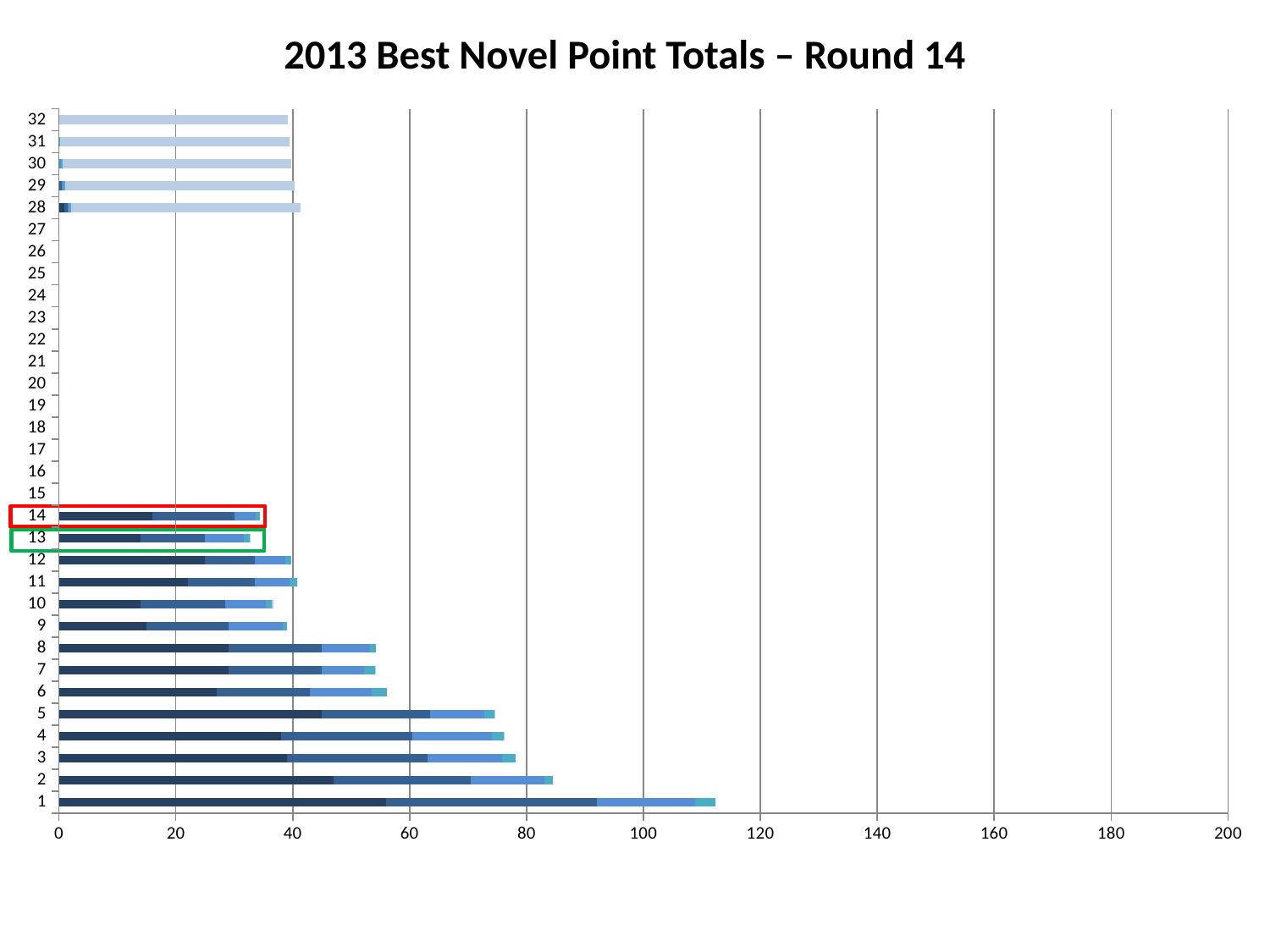
Is the total value for category 10 greater or less than 40? less Is the total value for category 2 greater or less than 80? greater What kind of chart is shown on the slide? bar chart Which has the larger total, category 5 or category 9? 5 Is the total value for category 1 greater or less than 100? greater What is the title of the chart? 2013 Best Novel Point Totals – Round 14 How many categories are listed on the vertical axis of the chart? 32 Which category has the longest bar in the chart? 1 Which category is outlined with a red box on the chart? 14